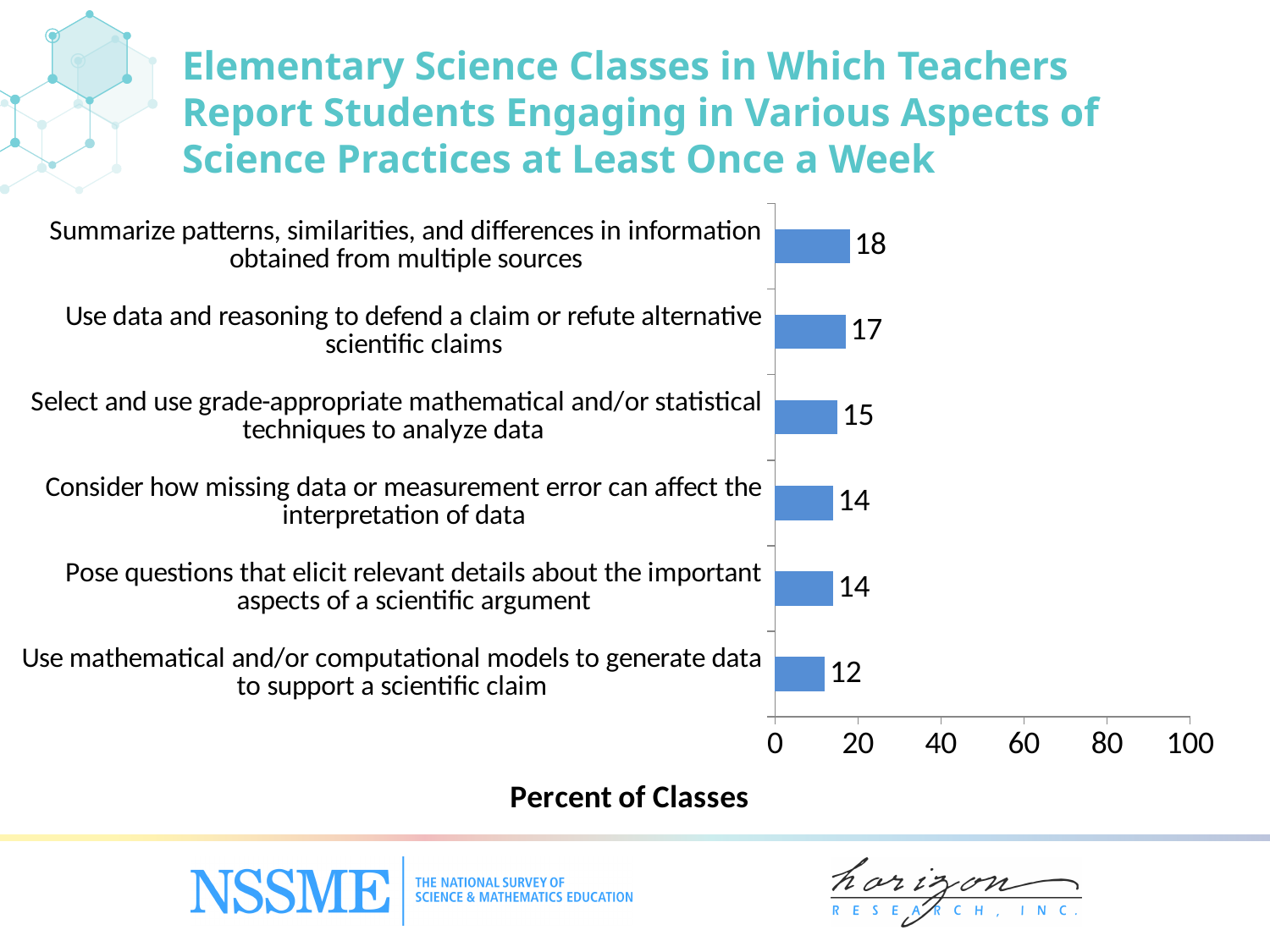
Which is larger: the value for "Use data and reasoning to defend a claim or refute alternative scientific claims" or the value for "Consider how missing data or measurement error can affect the interpretation of data"? Use data and reasoning to defend a claim or refute alternative scientific claims Which category has the highest percent of classes? Summarize patterns, similarities, and differences in information obtained from multiple sources Which category has the lowest percent of classes? Use mathematical and/or computational models to generate data to support a scientific claim How many categories are plotted in the chart? 6 What is the difference between the values for "Summarize patterns, similarities, and differences in information obtained from multiple sources" and "Use mathematical and/or computational models to generate data to support a scientific claim"? 6 What value is shown for "Use mathematical and/or computational models to generate data to support a scientific claim"? 12 What is the label of the horizontal axis? Percent of Classes What percent of classes is reported for "Summarize patterns, similarities, and differences in information obtained from multiple sources"? 18 What is the maximum value shown on the horizontal axis? 100 Is the value for "Pose questions that elicit relevant details about the important aspects of a scientific argument" greater or less than 20? less What kind of chart is shown on the slide? Bar chart What value is shown for "Select and use grade-appropriate mathematical and/or statistical techniques to analyze data"? 15